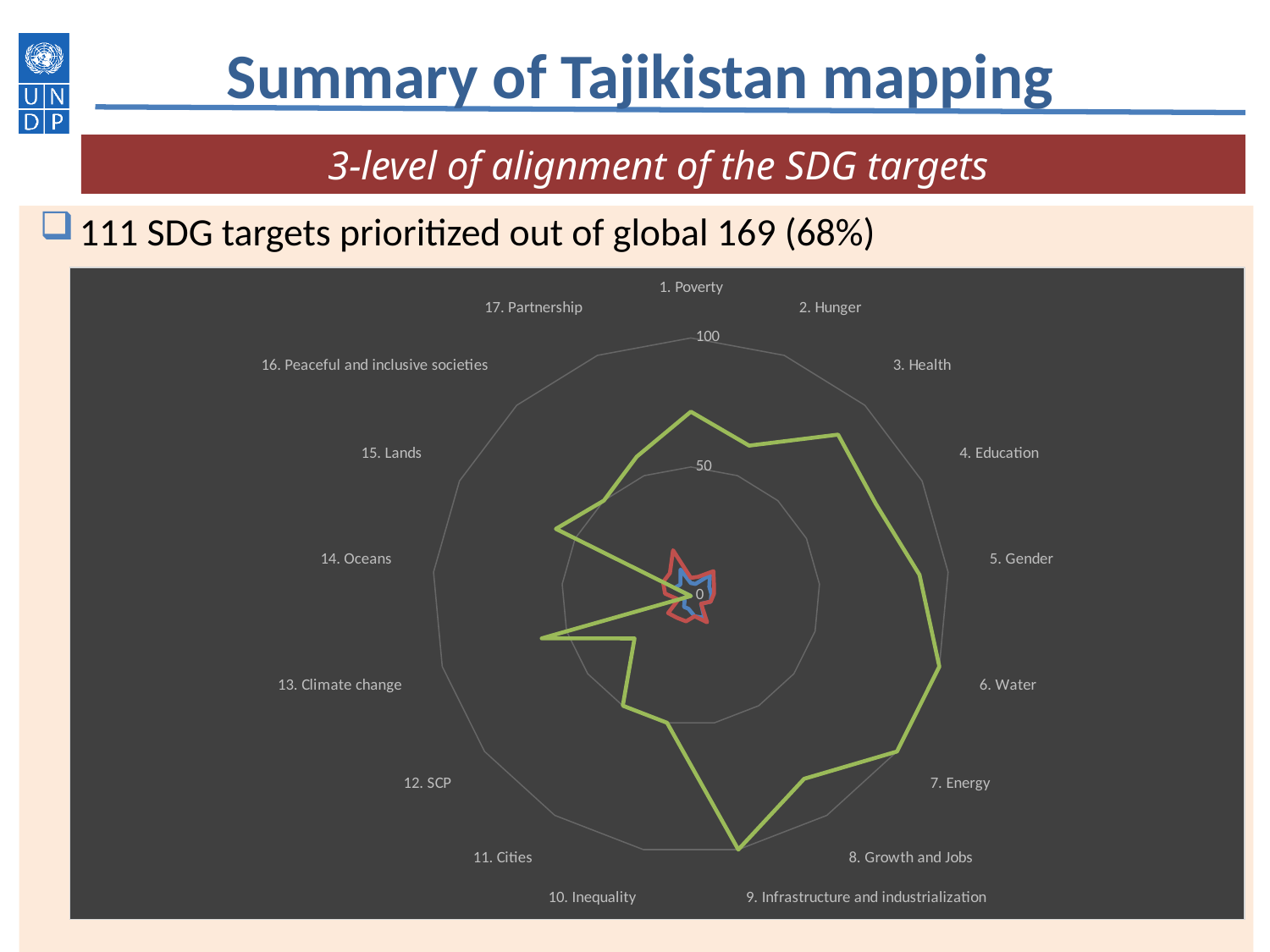
Is the green series value for 14. Oceans greater or less than 50? less Which category has the lowest value on the green series of the radar chart? 14. Oceans How many categories (SDG goals) are plotted around the radar chart? 17 On the green series, which has the larger value: 3. Health or 12. SCP? 3. Health How many data series (lines) are plotted on the radar chart? 3 Is the green series value for 6. Water greater or less than 50? greater Is the green series value for 1. Poverty greater or less than 50? greater What kind of chart is shown on the slide? Radar chart On the green series, which has the larger value: 6. Water or 14. Oceans? 6. Water What is the highest value shown on the radar chart's axis? 100